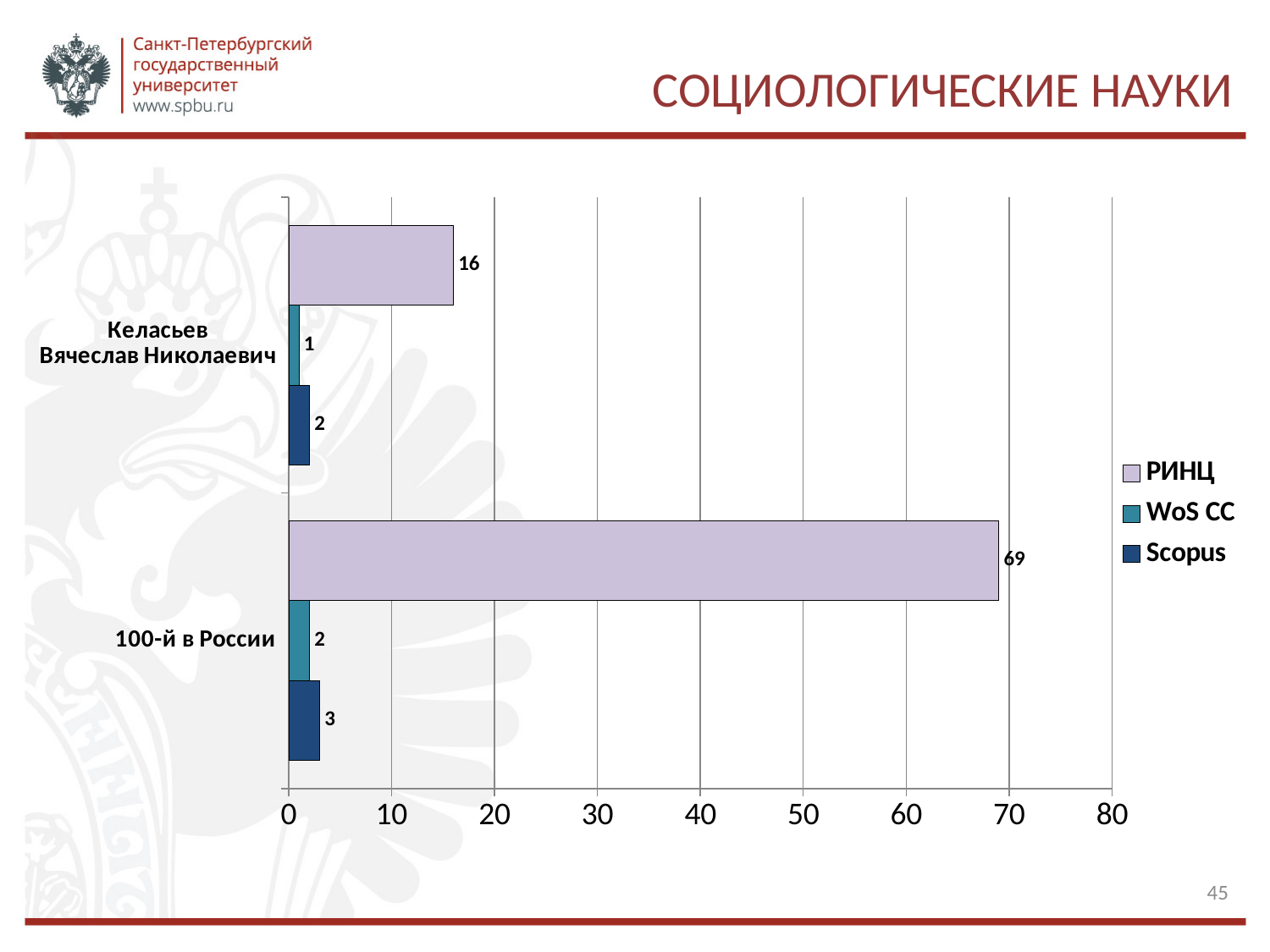
What is the difference between the РИНЦ values for 100-й в России and Келасьев Вячеслав Николаевич? 53 Is the Scopus value for Келасьев Вячеслав Николаевич larger or smaller than the Scopus value for 100-й в России? smaller How many series does the legend list? 3 How many categories are shown on the chart? 2 Which series has the lowest value for Келасьев Вячеслав Николаевич? WoS CC Is the РИНЦ value for 100-й в России greater or less than 60? greater What is the Scopus value for 100-й в России? 3 What kind of chart is shown on the slide? bar chart Which category has the higher РИНЦ value? 100-й в России What is the РИНЦ value for Келасьев Вячеслав Николаевич? 16 What is the WoS CC value for Келасьев Вячеслав Николаевич? 1 What is the РИНЦ value for 100-й в России? 69